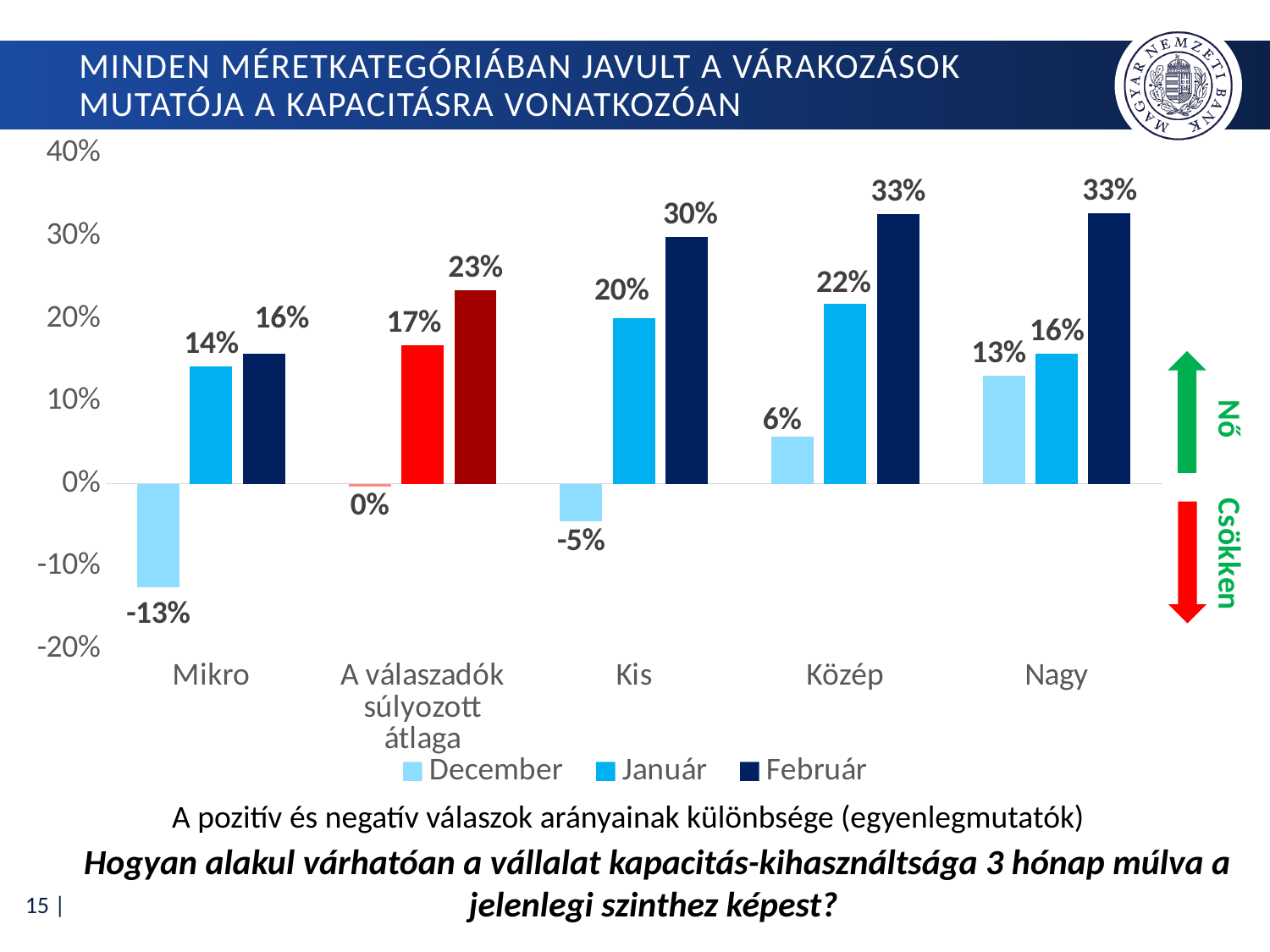
Which is larger for Nagy: the December value or the Január value? Január Which category has the lowest December value? Mikro What is the Február value for Kis? 30% What is the difference between the Február and Január values for Kis? 10% Which category has the highest Január value? Közép What kind of chart is shown on the slide? bar chart What is the Január value for Közép? 22% What is the Február value for A válaszadók súlyozott átlaga? 23% How many categories are shown on the x axis? 5 Which category has the lowest Február value? Mikro How many series does the legend list? 3 What is the December value for Mikro? -13%